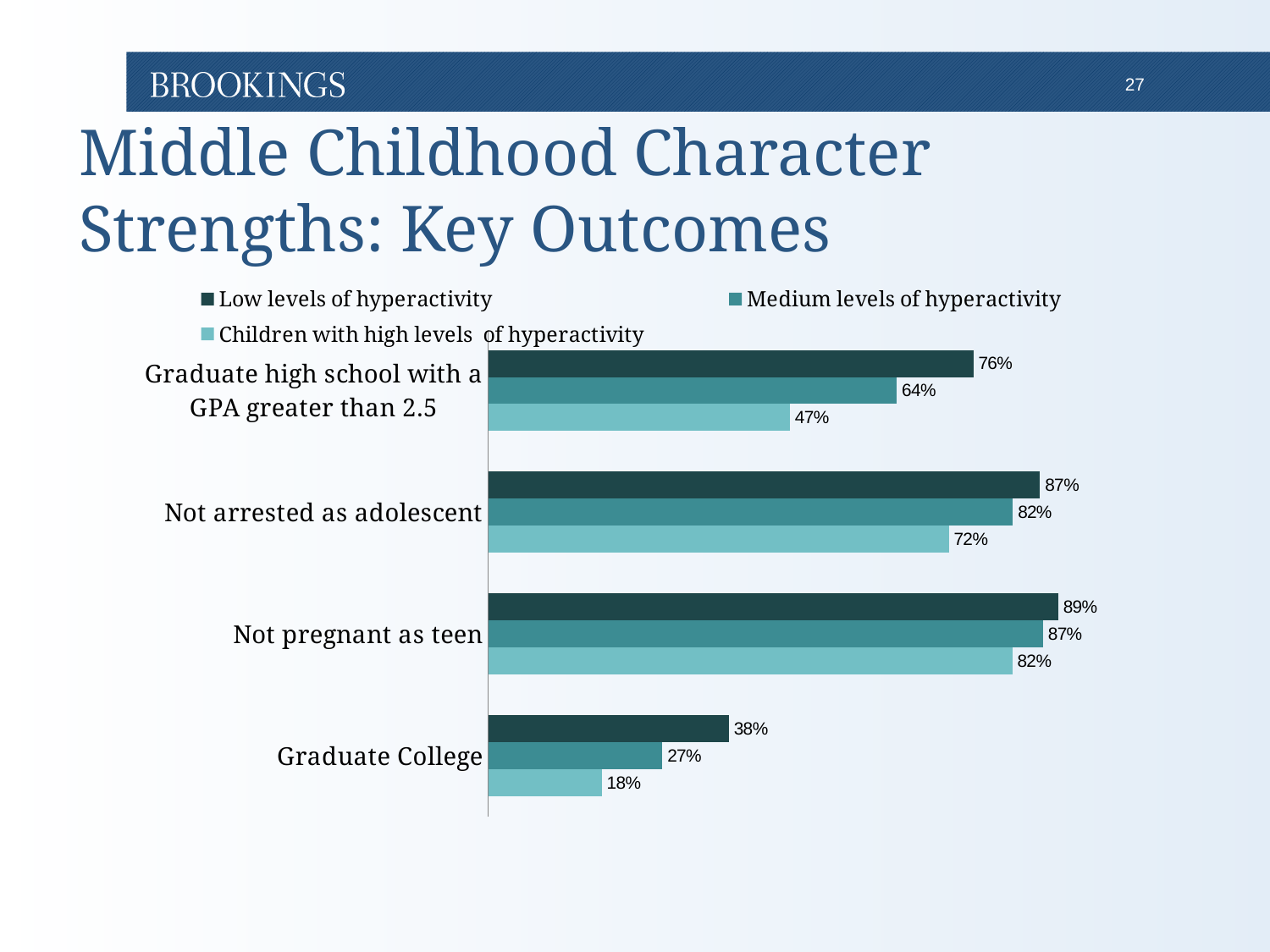
What kind of chart is shown on the slide? Bar chart What is the value for Children with high levels of hyperactivity in the Graduate College category? 18% How many outcome categories are shown on the chart? 4 Which is larger: the Children with high levels of hyperactivity value for Not arrested as adolescent or for Not pregnant as teen? Not pregnant as teen What is the value for Medium levels of hyperactivity in the Not arrested as adolescent category? 82% How many series does the legend list? 3 Which series is shown in the darkest colour in the legend? Low levels of hyperactivity What is the difference between the Low levels of hyperactivity and Medium levels of hyperactivity values in the Graduate College category? 11% What is the value for Low levels of hyperactivity in the Graduate high school with a GPA greater than 2.5 category? 76% Which category has the highest value for Low levels of hyperactivity? Not pregnant as teen Which category has the lowest value for Medium levels of hyperactivity? Graduate College What is the difference between the Low levels of hyperactivity and Children with high levels of hyperactivity values in the Graduate high school with a GPA greater than 2.5 category? 29%